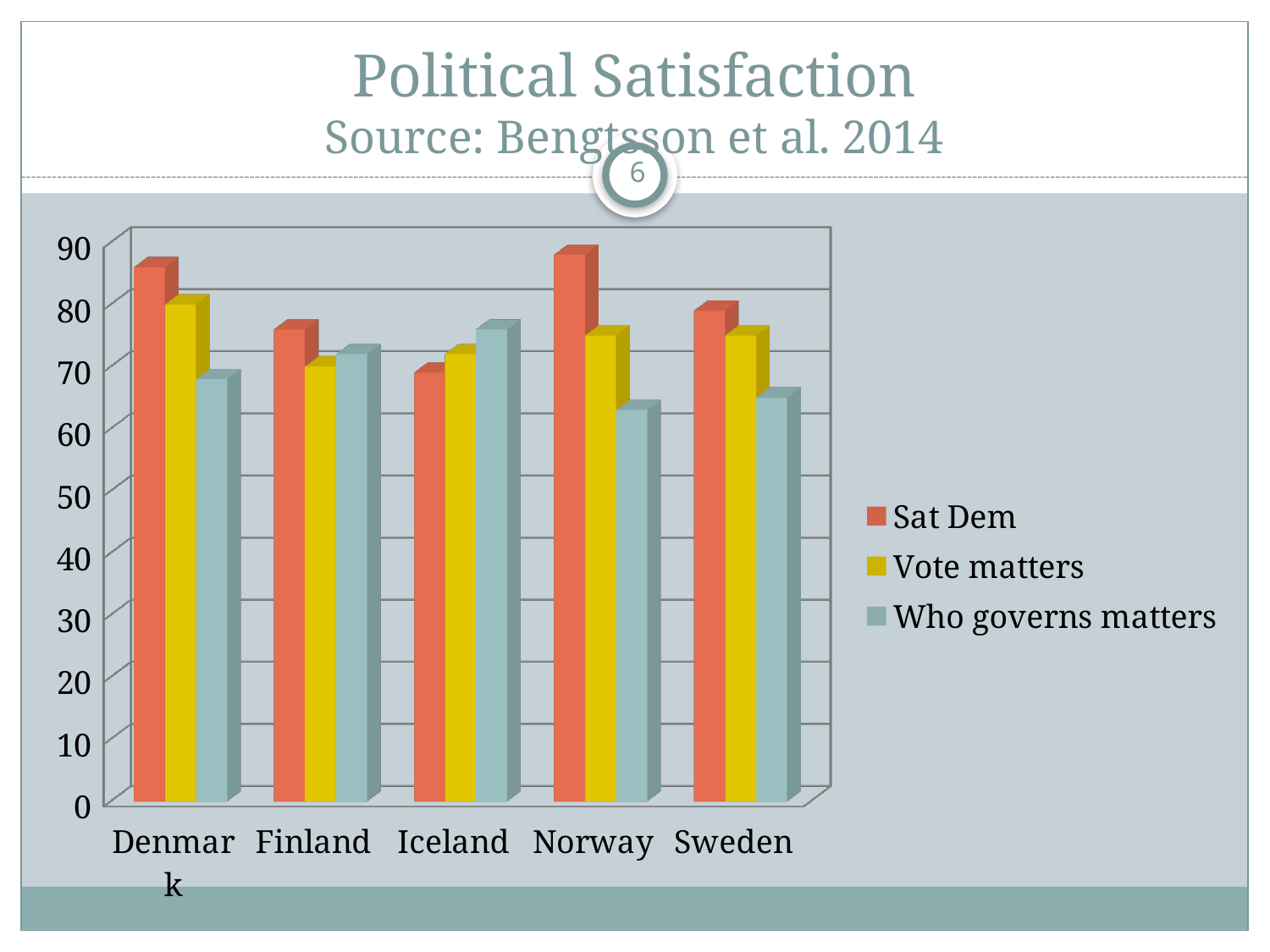
Is the Sat Dem value for Denmark greater or less than 80? greater For Denmark, which is larger: Sat Dem or Who governs matters? Sat Dem How many series does the chart's legend list? 3 Which country has the highest Vote matters value? Denmark Is the Sat Dem value for Finland greater or less than 70? greater How many countries are shown on the x axis of the chart? 5 Which country has the highest Sat Dem value? Norway What is the source cited in the chart's title? Bengtsson et al. 2014 Is the Who governs matters value for Norway greater or less than 70? less For Iceland, which is larger: Sat Dem or Who governs matters? Who governs matters What kind of chart is shown on the slide? Bar chart Which country has the lowest Sat Dem value? Iceland